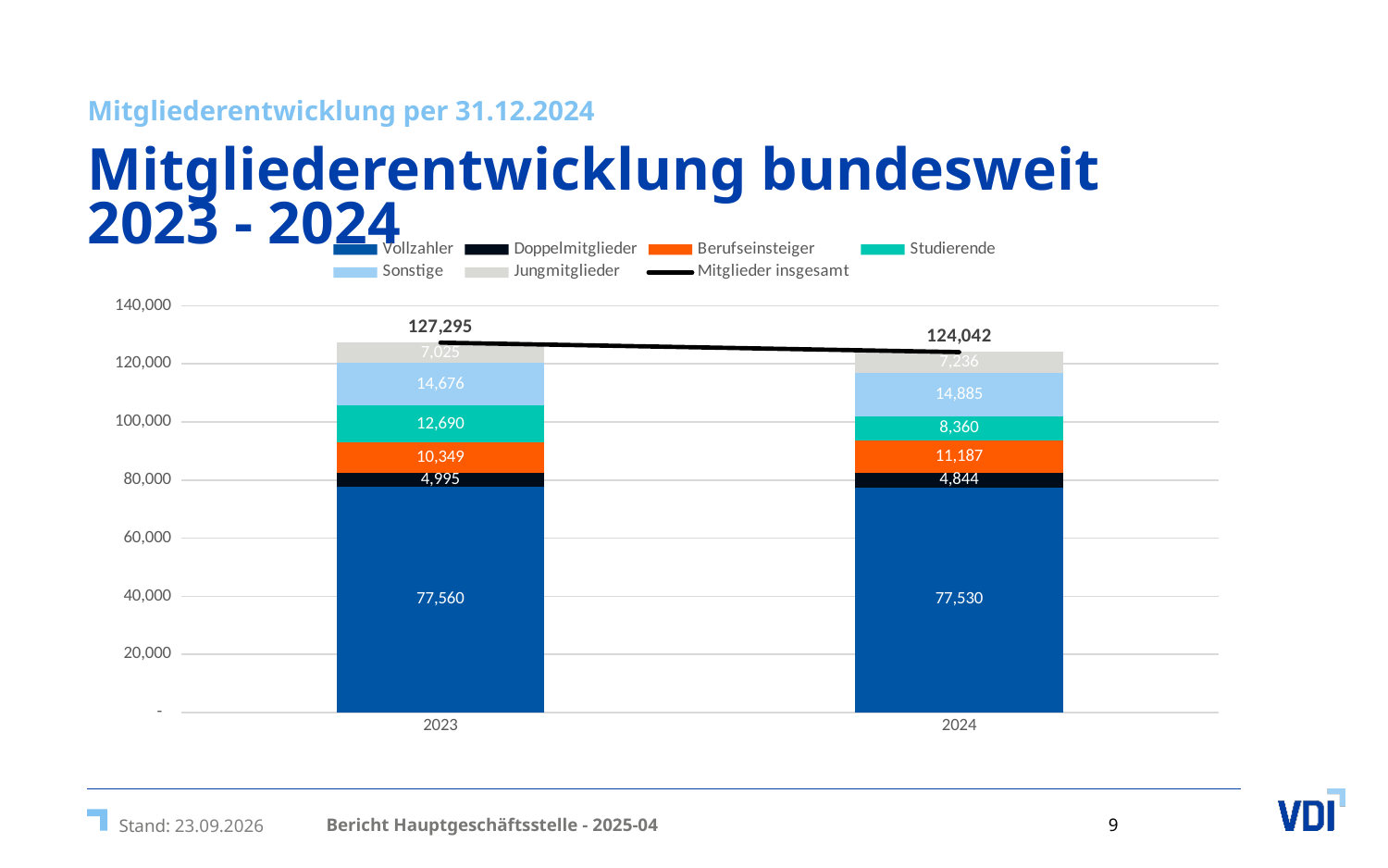
What kind of chart is shown on the slide? combination bar and line chart (stacked bars with a line) What is the difference between Mitglieder insgesamt in 2023 and 2024? 3,253 Does the Mitglieder insgesamt line rise or fall from 2023 to 2024? fall What is the value for Studierende in 2024? 8,360 What is the value of Mitglieder insgesamt for 2024? 124,042 Which colour represents Berufseinsteiger in the legend? orange What is the value for Sonstige in 2023? 14,676 By how much did the Studierende value decrease from 2023 to 2024? 4,330 How many years (categories) are shown on the x axis of the chart? 2 How many entries does the chart legend list? 7 What is the value for Vollzahler in 2023? 77,560 Which year has the larger Berufseinsteiger value, 2023 or 2024? 2024